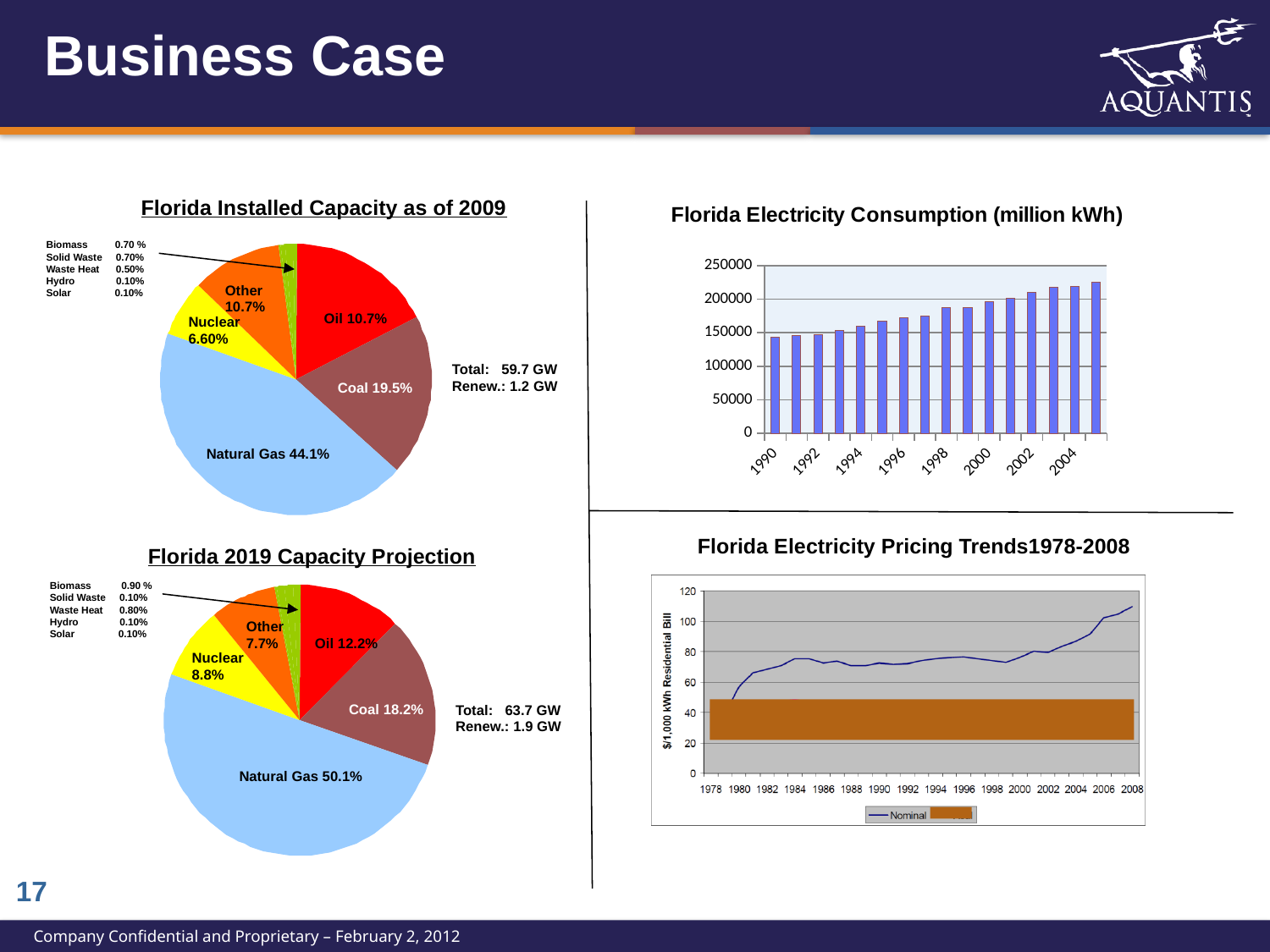
What kind of chart is the Florida Electricity Consumption (million kWh) chart? bar chart In the Florida Installed Capacity as of 2009 pie chart, what share does Natural Gas have? 44.1% In the Florida 2019 Capacity Projection pie chart, what share does Nuclear have? 8.8% In the Florida 2019 Capacity Projection pie chart, which category has the largest slice? Natural Gas In the Florida Installed Capacity as of 2009 pie chart, what is the difference between the Coal share and the Oil share? 8.8 percentage points In the Florida Electricity Consumption chart, do the values rise or fall from 1990 to 2005? rise What total installed capacity is stated next to the Florida 2019 Capacity Projection pie chart? 63.7 GW In the Florida 2019 Capacity Projection pie chart, what share does Coal have? 18.2% In the Florida Installed Capacity as of 2009 pie chart, which is larger, Nuclear or Oil? Oil What kind of chart is the Florida Electricity Pricing Trends 1978-2008 chart? line chart In the Florida Electricity Consumption chart, is the value for 1990 greater or less than 150000? less In the Florida Electricity Consumption chart, is the value for the last bar (2005) greater or less than 200000? greater